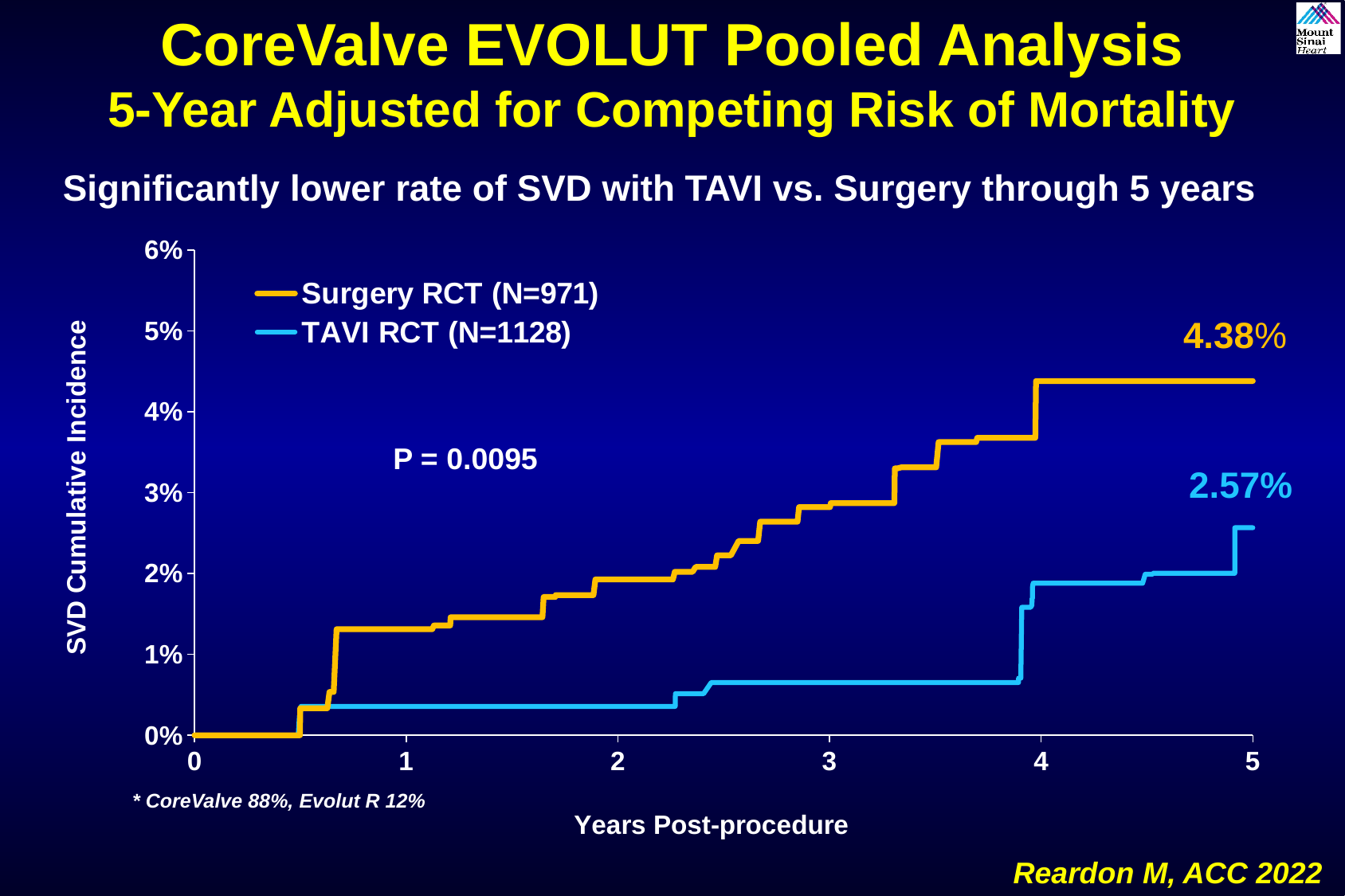
Which series has the higher SVD cumulative incidence at 5 years, Surgery RCT or TAVI RCT? Surgery RCT What is the SVD cumulative incidence for TAVI RCT at 5 years? 2.57% What is the sample size (N) given in the legend for TAVI RCT? 1128 What is the difference between the Surgery RCT and TAVI RCT SVD cumulative incidence at 5 years? 1.81% Is the SVD cumulative incidence for Surgery RCT at 2 years greater or less than 1%? greater How many series does the legend list? 2 Is the SVD cumulative incidence for Surgery RCT at 3 years greater or less than 2%? greater Do the SVD cumulative incidence curves rise or fall as years post-procedure increase? Rise What kind of chart is shown on the slide? Line chart Is the SVD cumulative incidence for TAVI RCT at 3 years greater or less than 1%? less What is the SVD cumulative incidence for Surgery RCT at 5 years? 4.38% What P value is shown on the chart? P = 0.0095